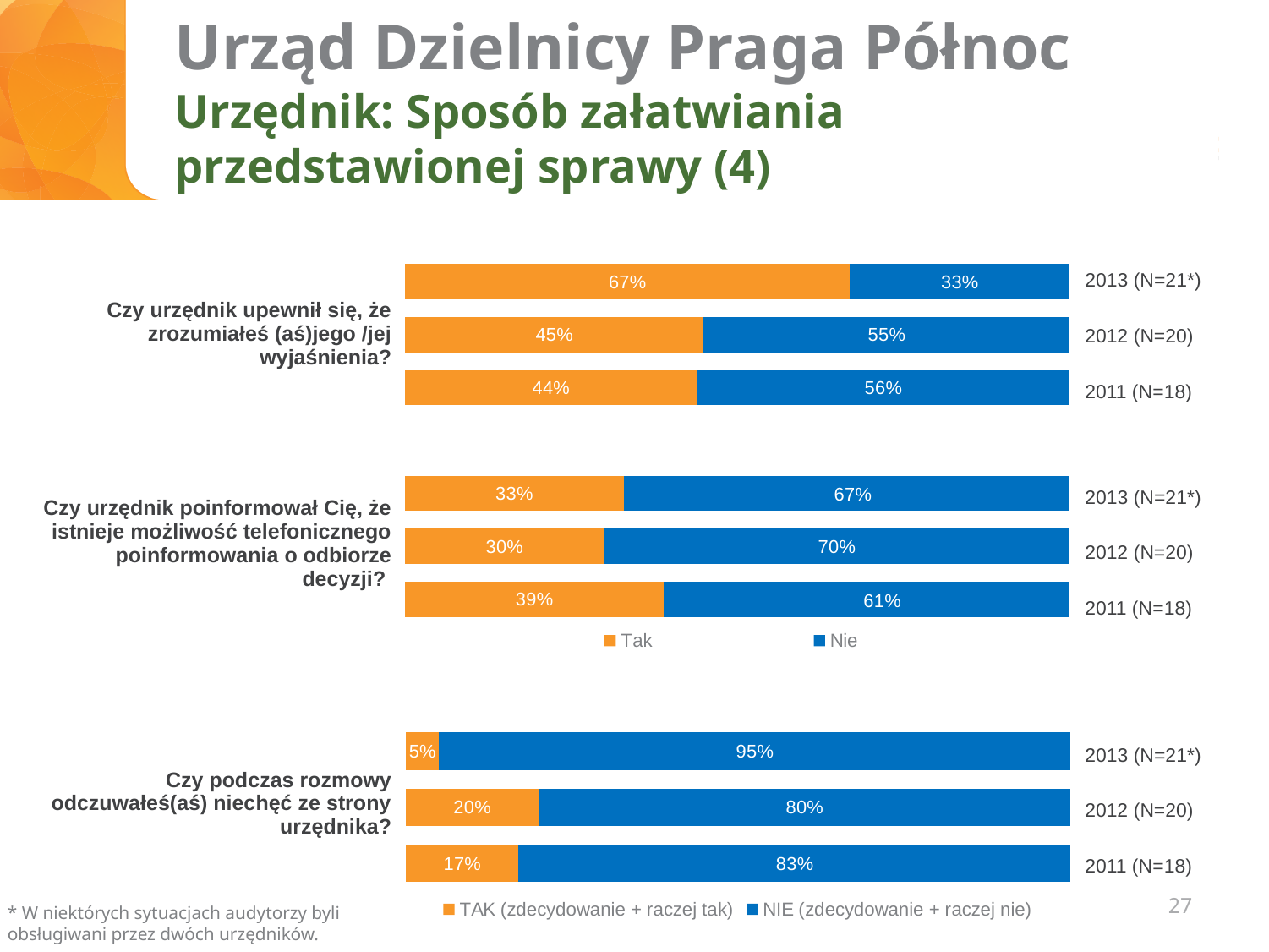
In the chart for "Czy urzędnik upewnił się, że zrozumiałeś (aś) jego/jej wyjaśnienia?", which year has the highest Tak value? 2013 (N=21*) How many bars does the chart for "Czy urzędnik upewnił się, że zrozumiałeś (aś) jego/jej wyjaśnienia?" contain? 3 In the chart for "Czy urzędnik poinformował Cię, że istnieje możliwość telefonicznego poinformowania o odbiorze decyzji?", which year has the lowest Tak value? 2012 (N=20) In the chart for "Czy podczas rozmowy odczuwałeś(aś) niechęć ze strony urzędnika?", what is the total of the 2012 (N=20) bar? 100% In the chart for "Czy urzędnik poinformował Cię, że istnieje możliwość telefonicznego poinformowania o odbiorze decyzji?", what is the difference between the Nie and Tak values for 2011 (N=18)? 22 percentage points In the chart for "Czy podczas rozmowy odczuwałeś(aś) niechęć ze strony urzędnika?", is the TAK value larger for 2012 (N=20) or 2011 (N=18)? 2012 (N=20) In the chart for "Czy urzędnik poinformował Cię, że istnieje możliwość telefonicznego poinformowania o odbiorze decyzji?", what is the Nie value for 2012 (N=20)? 70% In the chart for "Czy urzędnik upewnił się, że zrozumiałeś (aś) jego/jej wyjaśnienia?", what is the Nie value for 2011 (N=18)? 56% In the chart for "Czy podczas rozmowy odczuwałeś(aś) niechęć ze strony urzędnika?", which year has the highest NIE value? 2013 (N=21*) In the chart for "Czy podczas rozmowy odczuwałeś(aś) niechęć ze strony urzędnika?", what is the TAK value for 2013 (N=21*)? 5% In the chart for "Czy urzędnik upewnił się, że zrozumiałeś (aś) jego/jej wyjaśnienia?", what is the Tak value for 2013 (N=21*)? 67% What type of chart is used for "Czy podczas rozmowy odczuwałeś(aś) niechęć ze strony urzędnika?"? Stacked bar chart